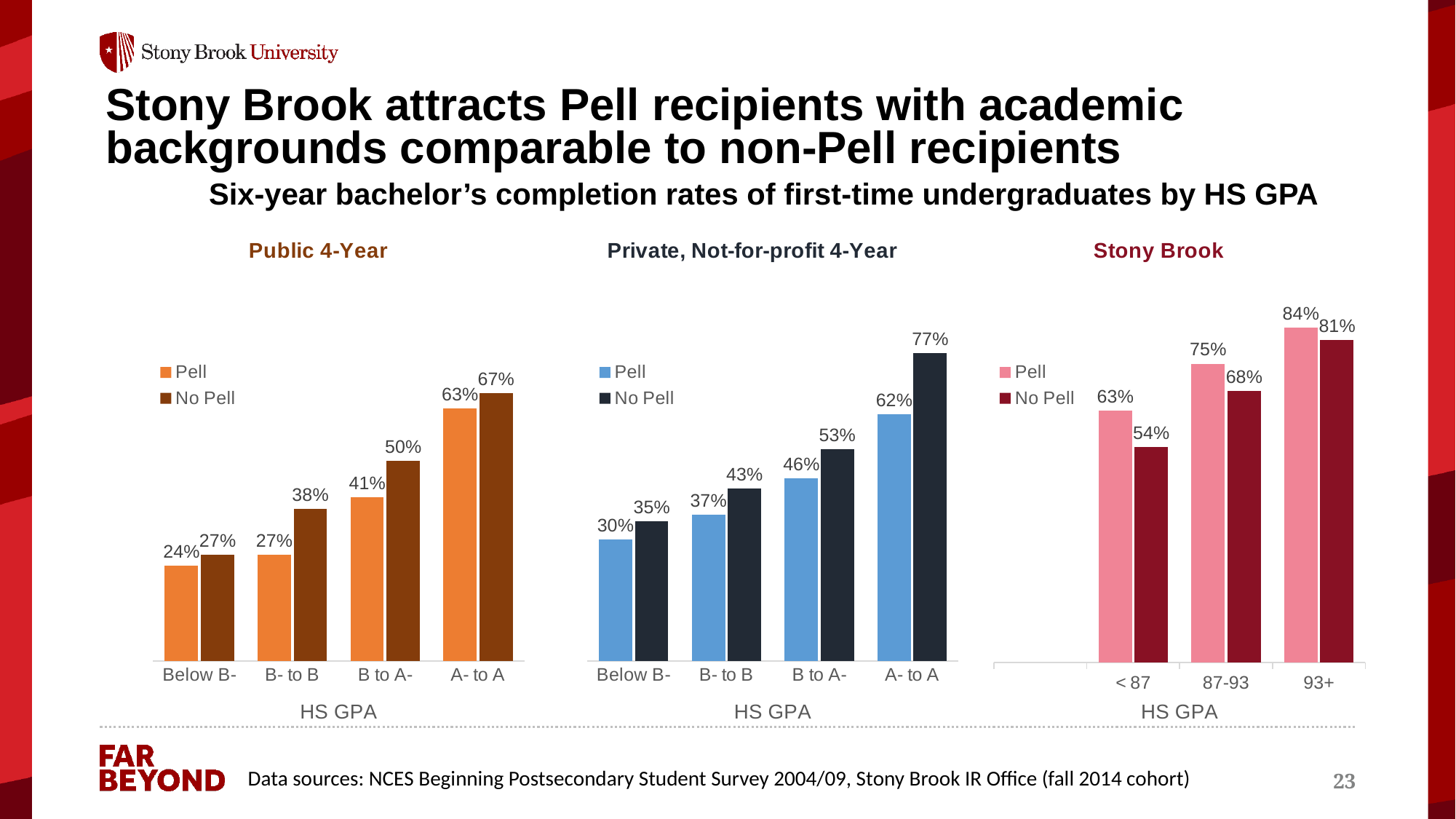
In the Public 4-Year chart, what is the completion rate for Pell recipients with a HS GPA of B to A-? 41% In the Private, Not-for-profit 4-Year chart, what is the completion rate for No Pell students with a HS GPA of A- to A? 77% In the Stony Brook chart, what is the completion rate for Pell recipients with a HS GPA of 87-93? 75% What type of chart is the Private, Not-for-profit 4-Year chart? Bar chart In the Public 4-Year chart, which HS GPA category has the lowest completion rate for Pell recipients? Below B- How many series does the legend of the Stony Brook chart list? 2 In the Stony Brook chart, which HS GPA category has the highest completion rate for No Pell students? 93+ In the Stony Brook chart, what is the difference between the Pell and No Pell completion rates for the < 87 category? 9% In the Public 4-Year chart, do the No Pell completion rates rise or fall as HS GPA increases from Below B- to A- to A? Rise In the Private, Not-for-profit 4-Year chart, what is the difference between the No Pell and Pell completion rates for the A- to A category? 15% In the Stony Brook chart, which is larger for the 93+ category: the Pell rate or the No Pell rate? Pell In the Public 4-Year chart, how many HS GPA categories are shown? 4